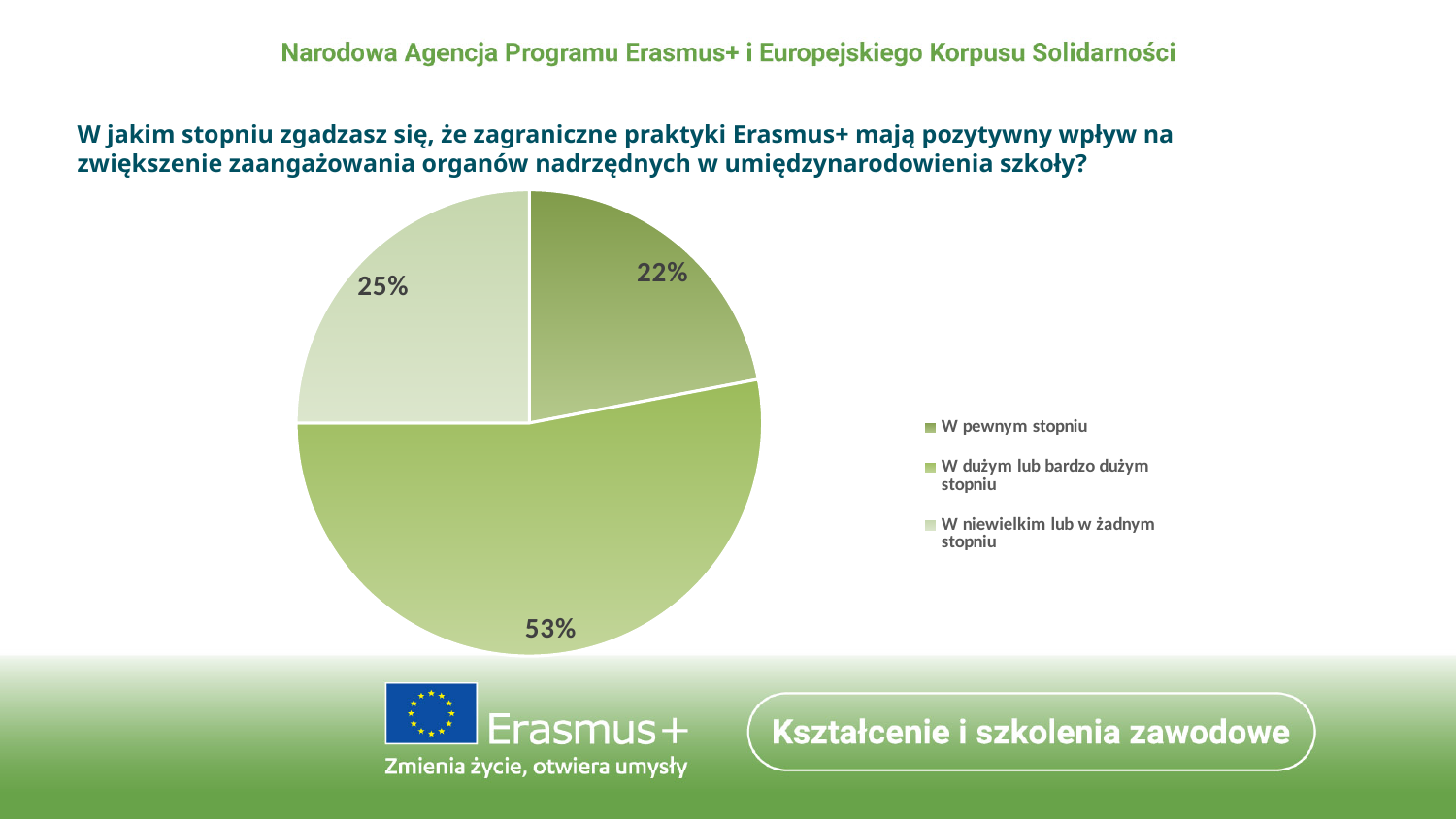
What share of the pie is labelled "W pewnym stopniu"? 22% How many entries does the legend list? 3 How many slices does the pie chart have? 3 What share of the pie is labelled "W dużym lub bardzo dużym stopniu"? 53% What is the difference in percentage points between the "W dużym lub bardzo dużym stopniu" slice and the "W niewielkim lub w żadnym stopniu" slice? 28 Which category has the smallest slice of the pie? W pewnym stopniu Which is larger: the "W niewielkim lub w żadnym stopniu" slice or the "W pewnym stopniu" slice? W niewielkim lub w żadnym stopniu Which category has the largest slice of the pie? W dużym lub bardzo dużym stopniu Which legend entry is shown in the lightest green colour? W niewielkim lub w żadnym stopniu What is the difference in percentage points between the "W niewielkim lub w żadnym stopniu" slice and the "W pewnym stopniu" slice? 3 What share of the pie is labelled "W niewielkim lub w żadnym stopniu"? 25% What kind of chart is shown on the slide? pie chart